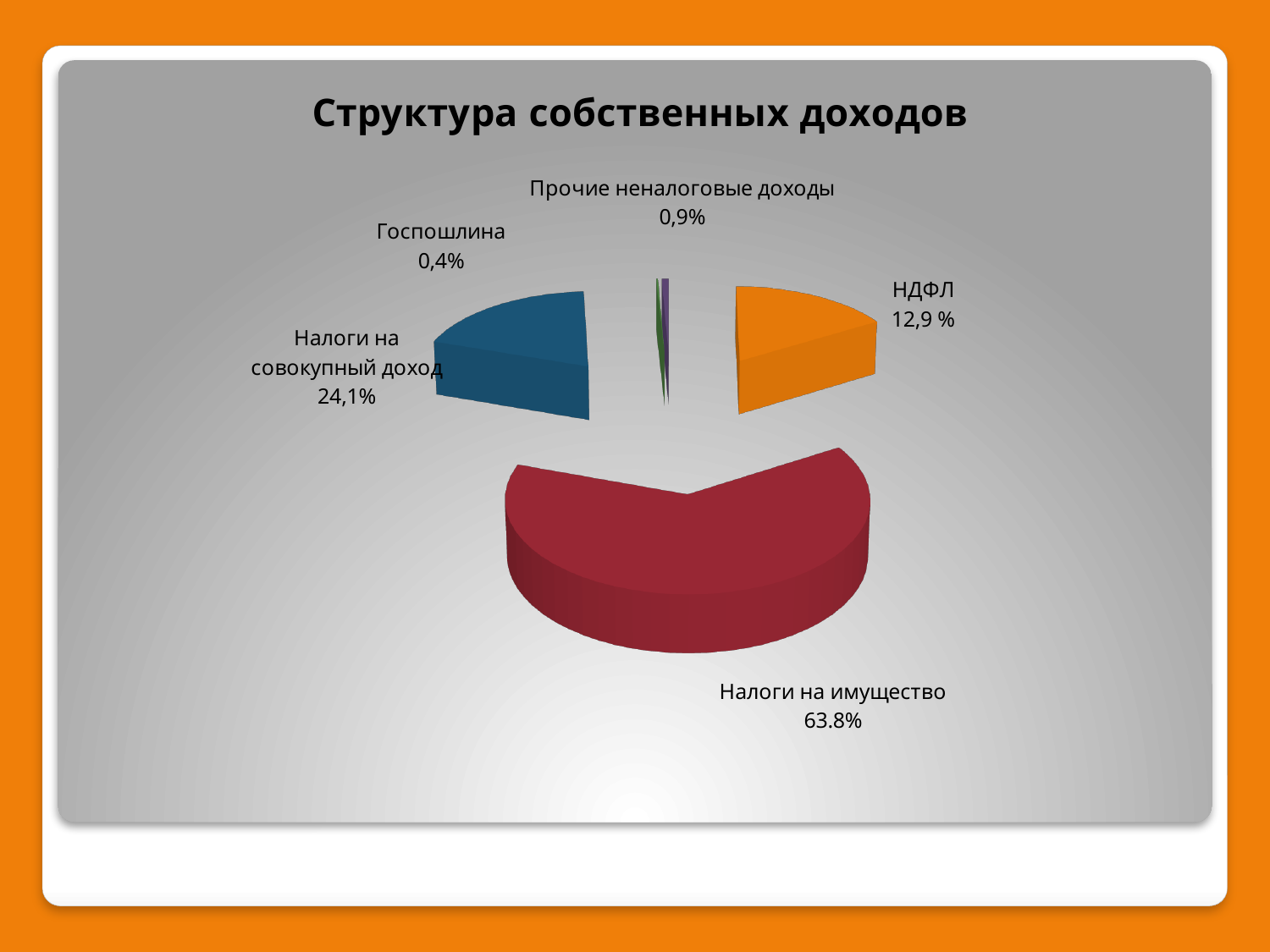
Which is larger: the share for Налоги на совокупный доход or the share for НДФЛ? Налоги на совокупный доход What share of the pie is labelled for Налоги на имущество? 63.8% What share is shown for Госпошлина? 0,4% What share is shown for Налоги на совокупный доход? 24,1% How many slices does the pie chart have? 5 What share is shown for НДФЛ? 12,9 % Which category has the smallest share of the pie? Госпошлина What share is shown for Прочие неналоговые доходы? 0,9% Which category has the largest share of the pie? Налоги на имущество What is the title of the chart? Структура собственных доходов What kind of chart is shown on the slide? Pie chart What colour is the slice for Налоги на имущество? Red